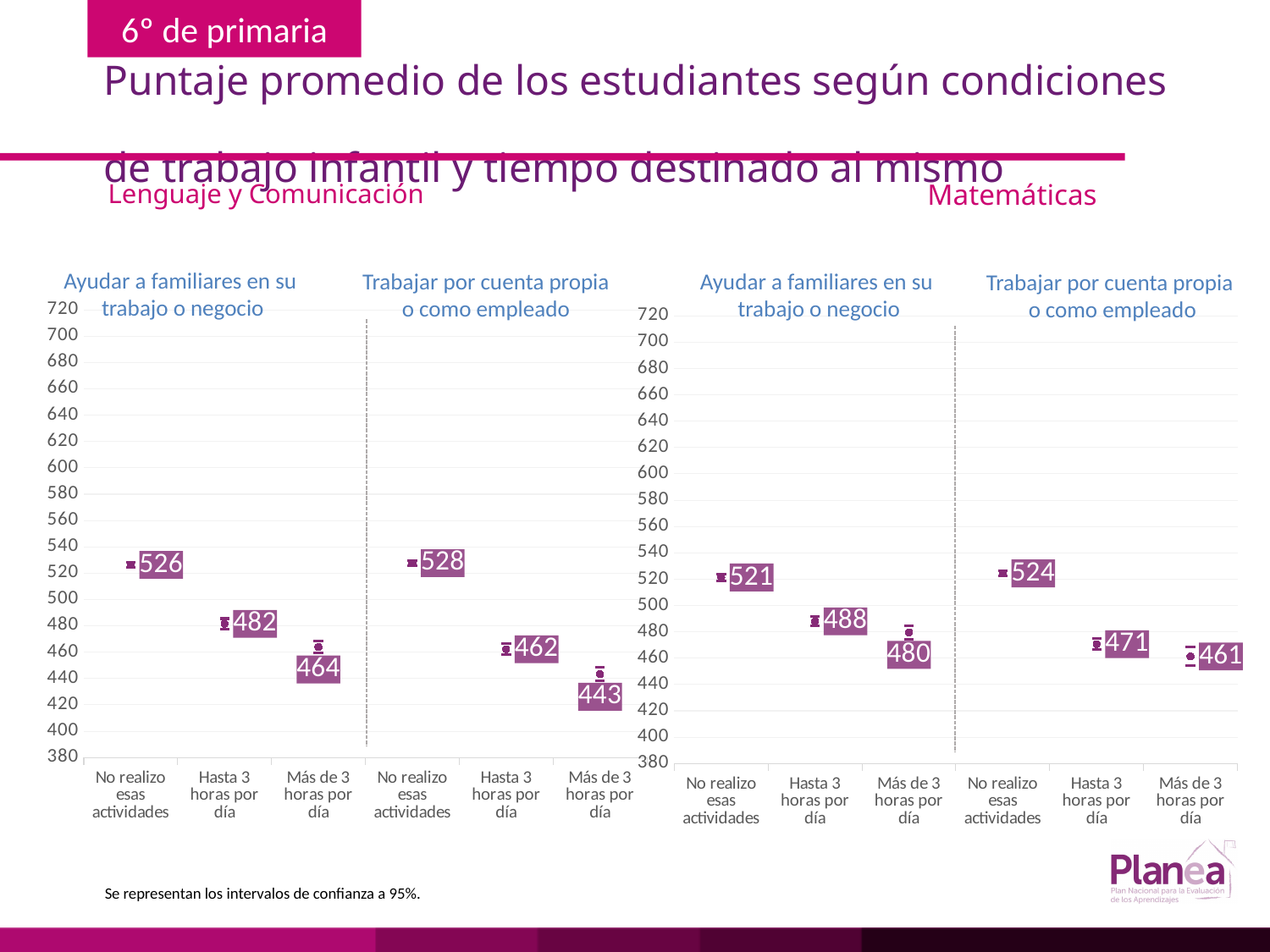
In the Lenguaje y Comunicación chart, what is the difference between the score for students who do not help family members (526) and those who help more than 3 hours per day (464)? 62 In the Lenguaje y Comunicación chart, what is the average score for students who work on their own or as employees more than 3 hours per day? 443 How many data points are plotted in the Matemáticas chart? 6 In the Lenguaje y Comunicación chart, which category has the lowest average score? Más de 3 horas por día (Trabajar por cuenta propia o como empleado) In the Matemáticas chart, which is larger: the score for helping family members more than 3 hours per day or the score for working on one's own more than 3 hours per day? Helping family members more than 3 hours per day (480) In the Lenguaje y Comunicación chart, what is the average score for students who do not help family members in their work or business ("No realizo esas actividades" under "Ayudar a familiares en su trabajo o negocio")? 526 In the Matemáticas chart, what is the average score for students who work on their own or as employees up to 3 hours per day? 471 In the Matemáticas chart, what is the average score for students who help family members up to 3 hours per day? 488 In the Matemáticas chart, which category has the highest average score? No realizo esas actividades (Trabajar por cuenta propia o como empleado) What does the note at the bottom of the slide say is represented in the charts? Los intervalos de confianza a 95% In the Matemáticas chart, what is the difference between the score for students who do not work on their own (524) and those who work more than 3 hours per day (461)? 63 In the Lenguaje y Comunicación chart, do the scores rise or fall as the hours spent helping family members increase? Fall